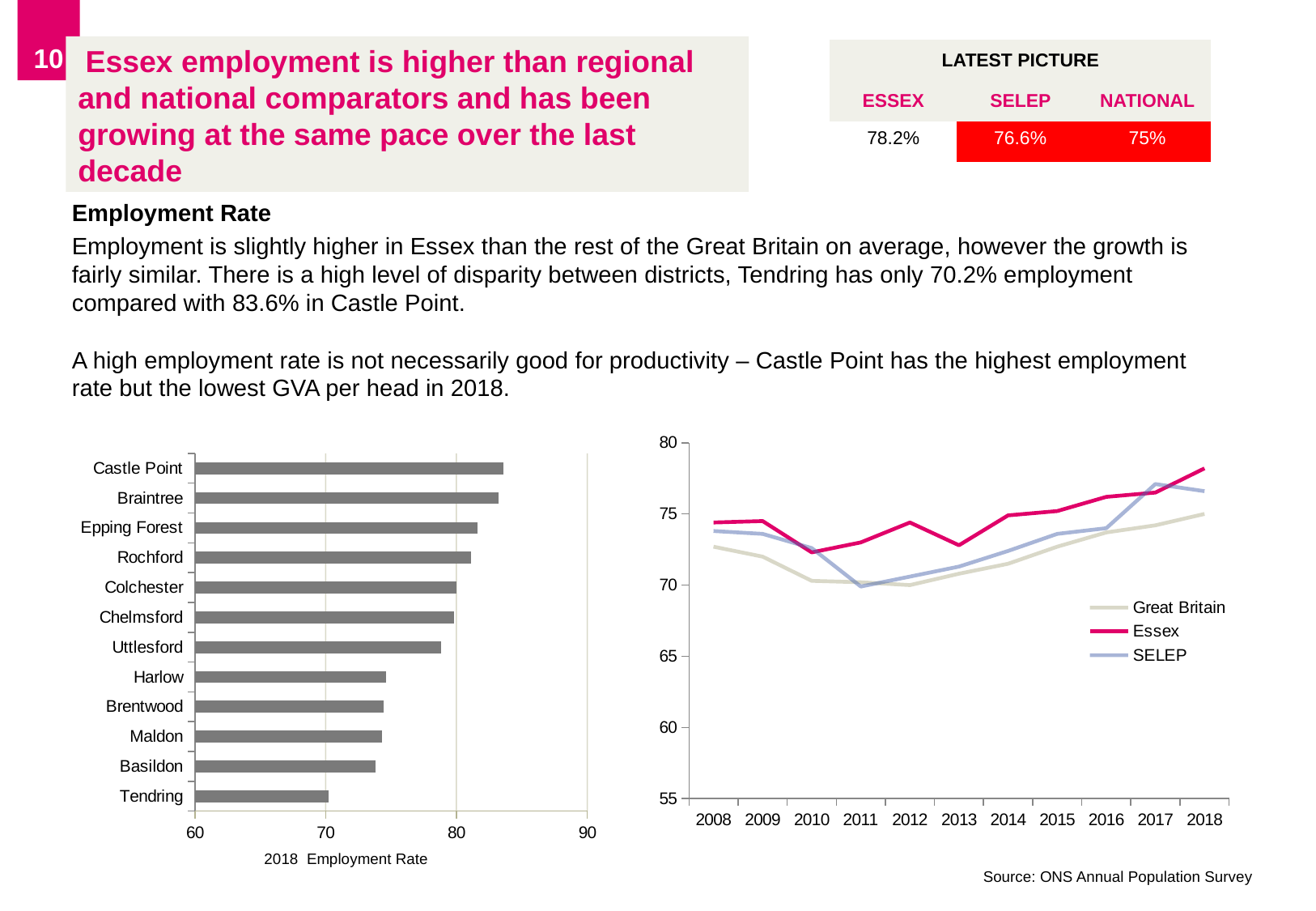
In the right line chart, is the value for Great Britain in 2011 greater or less than 75? less In the left bar chart, which district has the highest 2018 employment rate? Castle Point What kind of chart is the chart on the right of the slide? line chart How many districts are shown in the left bar chart? 12 What kind of chart is the chart on the left of the slide? bar chart In the left bar chart, is the value for Castle Point greater or less than 80? greater How many series does the legend of the right line chart list? 3 In the right line chart, which series has the highest value in 2018? Essex In the left bar chart, which has the larger value, Braintree or Basildon? Braintree In the left bar chart, which district has the lowest 2018 employment rate? Tendring In the left bar chart, is the value for Harlow greater or less than 80? less In the right line chart, does the Essex line rise or fall from 2013 to 2018? rise